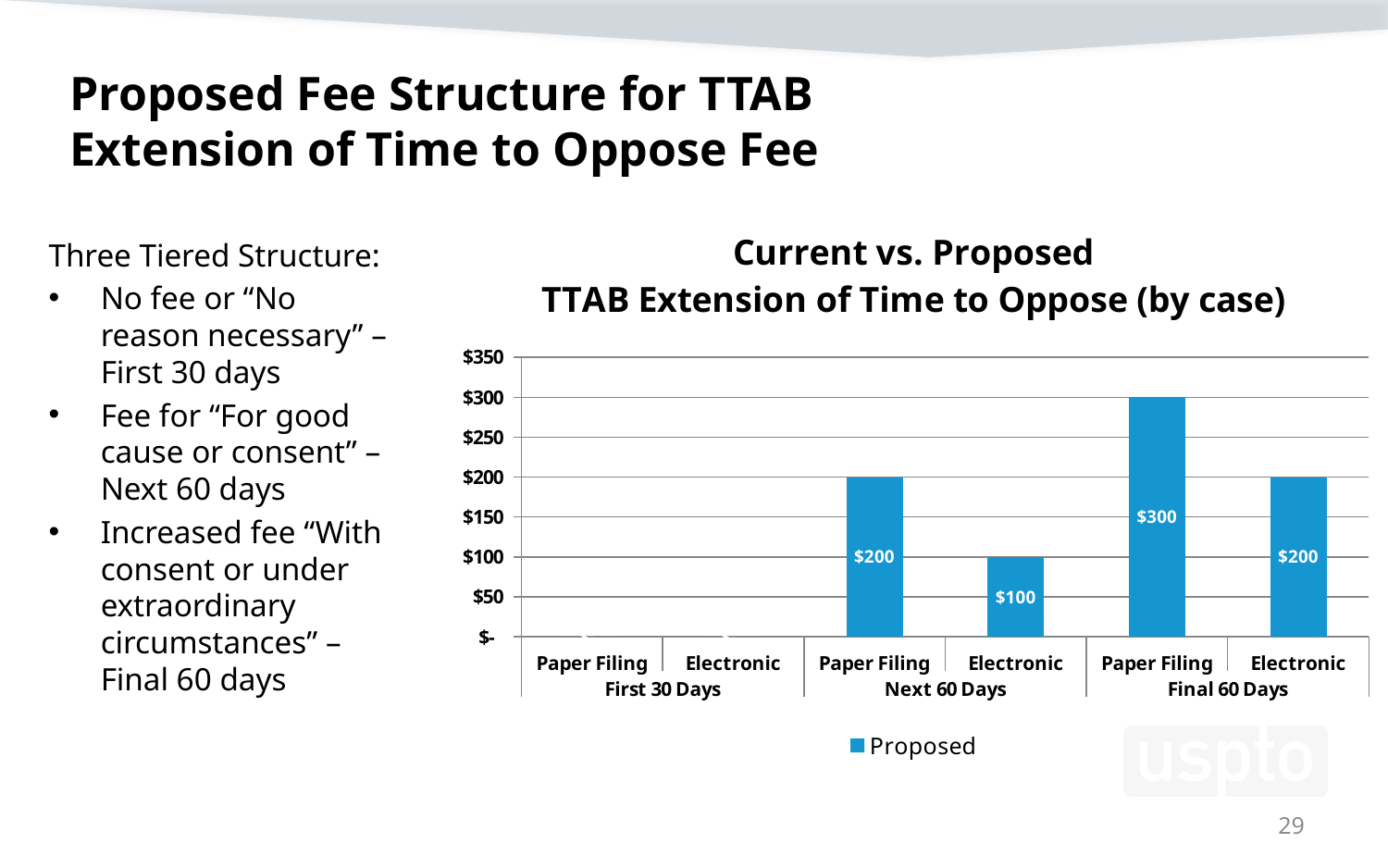
Is the proposed fee for Paper Filing in the Final 60 Days greater or less than $250? greater What is the proposed fee for Electronic filing in the Next 60 Days? $100 What is the name of the series shown in the legend? Proposed Which category has the highest proposed fee? Paper Filing, Final 60 Days What is the difference between the Paper Filing fee in the Final 60 Days and the Electronic fee in the Next 60 Days? $200 What is the proposed fee for Paper Filing in the Final 60 Days? $300 In the Next 60 Days, which is larger: the Paper Filing fee or the Electronic fee? Paper Filing What is the difference between the Paper Filing and Electronic proposed fees in the Final 60 Days? $100 How many series does the legend list? 1 What kind of chart is shown on the slide? Bar chart What is the proposed fee for Electronic filing in the Final 60 Days? $200 What is the proposed fee for Paper Filing in the Next 60 Days? $200